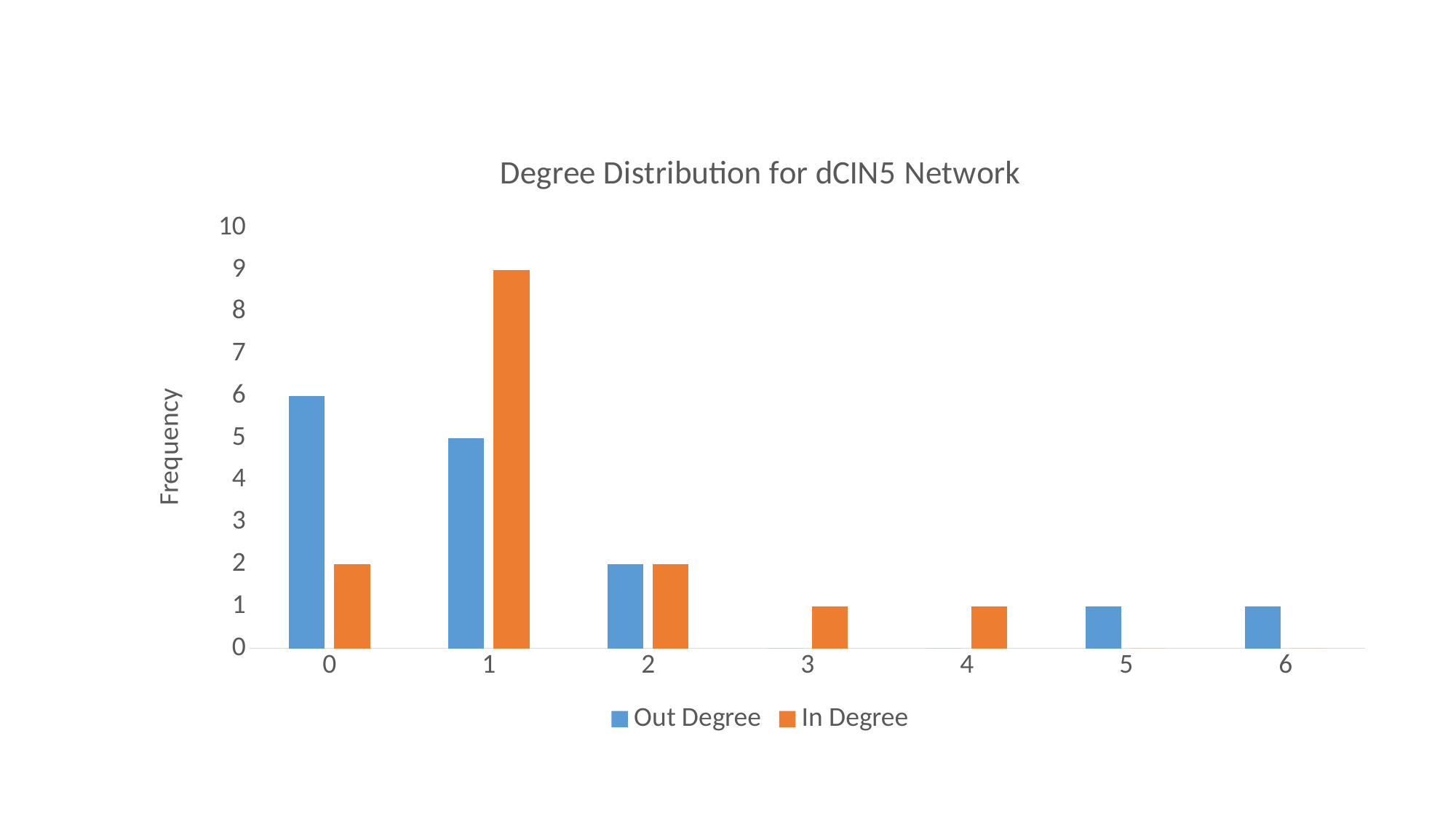
How many series does the legend list? 2 How many degree categories are shown on the x axis? 7 What is the difference between the In Degree and Out Degree frequencies at degree 1? 4 At degree 0, which series has the larger frequency, Out Degree or In Degree? Out Degree What is the Out Degree frequency for degree 1? 5 What is the title of the chart? Degree Distribution for dCIN5 Network What is the In Degree frequency for degree 1? 9 Which degree has the highest In Degree frequency? 1 Is the In Degree frequency for degree 1 greater or less than 8? greater Which degree has the highest Out Degree frequency? 0 What kind of chart is shown on the slide? bar chart What is the Out Degree frequency for degree 0? 6